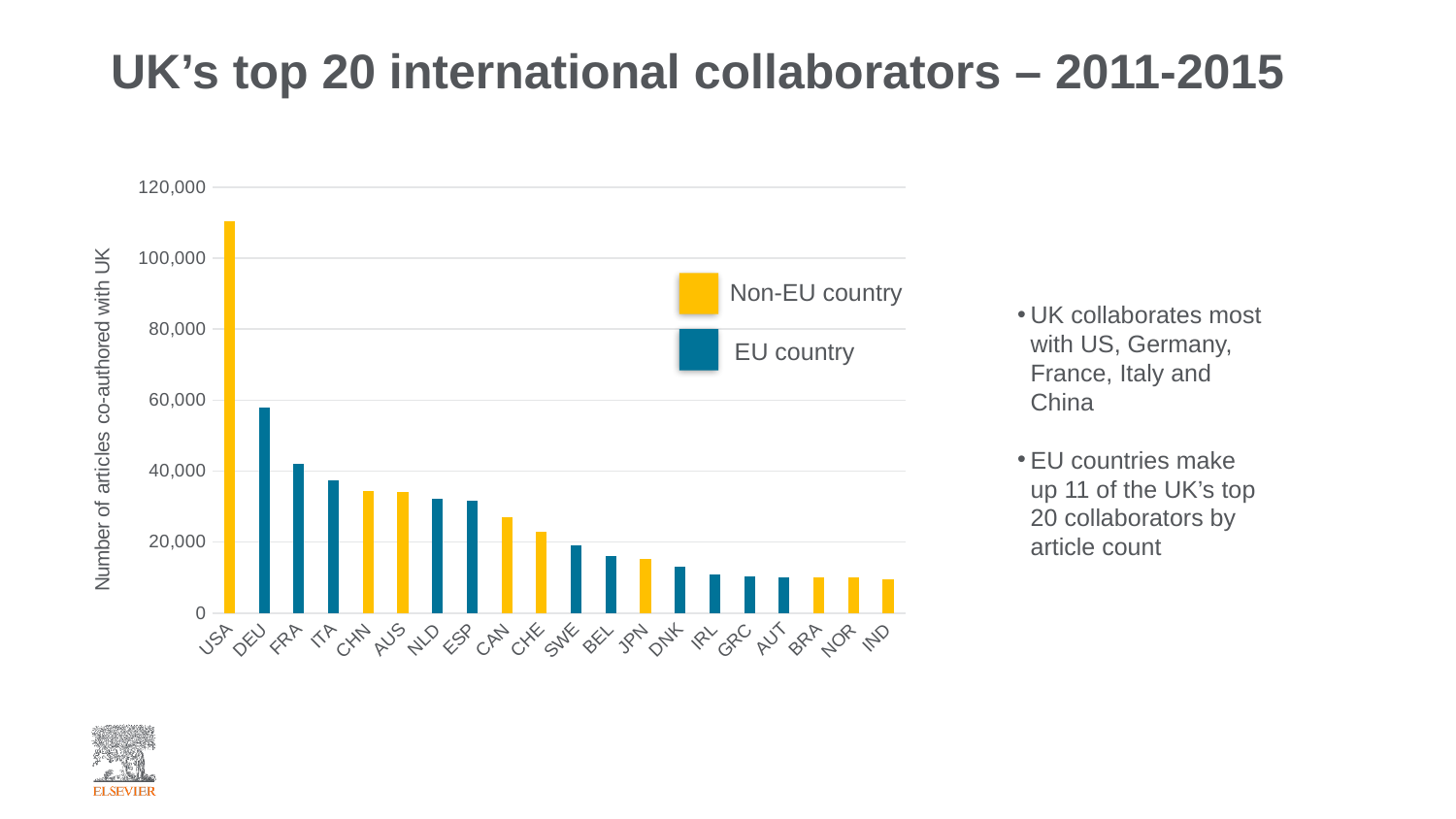
How many entries does the chart's legend list? 2 Which country has the highest number of articles co-authored with the UK? USA Is the value for USA greater or less than 100,000? greater What does the yellow colour in the legend represent? Non-EU country Which has a higher value, USA or DEU? USA Is the value for FRA greater or less than 40,000? greater How many countries are shown on the x axis of the chart? 20 Do the bar values rise or fall from left to right along the x axis? Fall Which has a higher value, CAN or SWE? CAN What type of chart is shown on the slide? Bar chart Is the value for DEU greater or less than 60,000? less